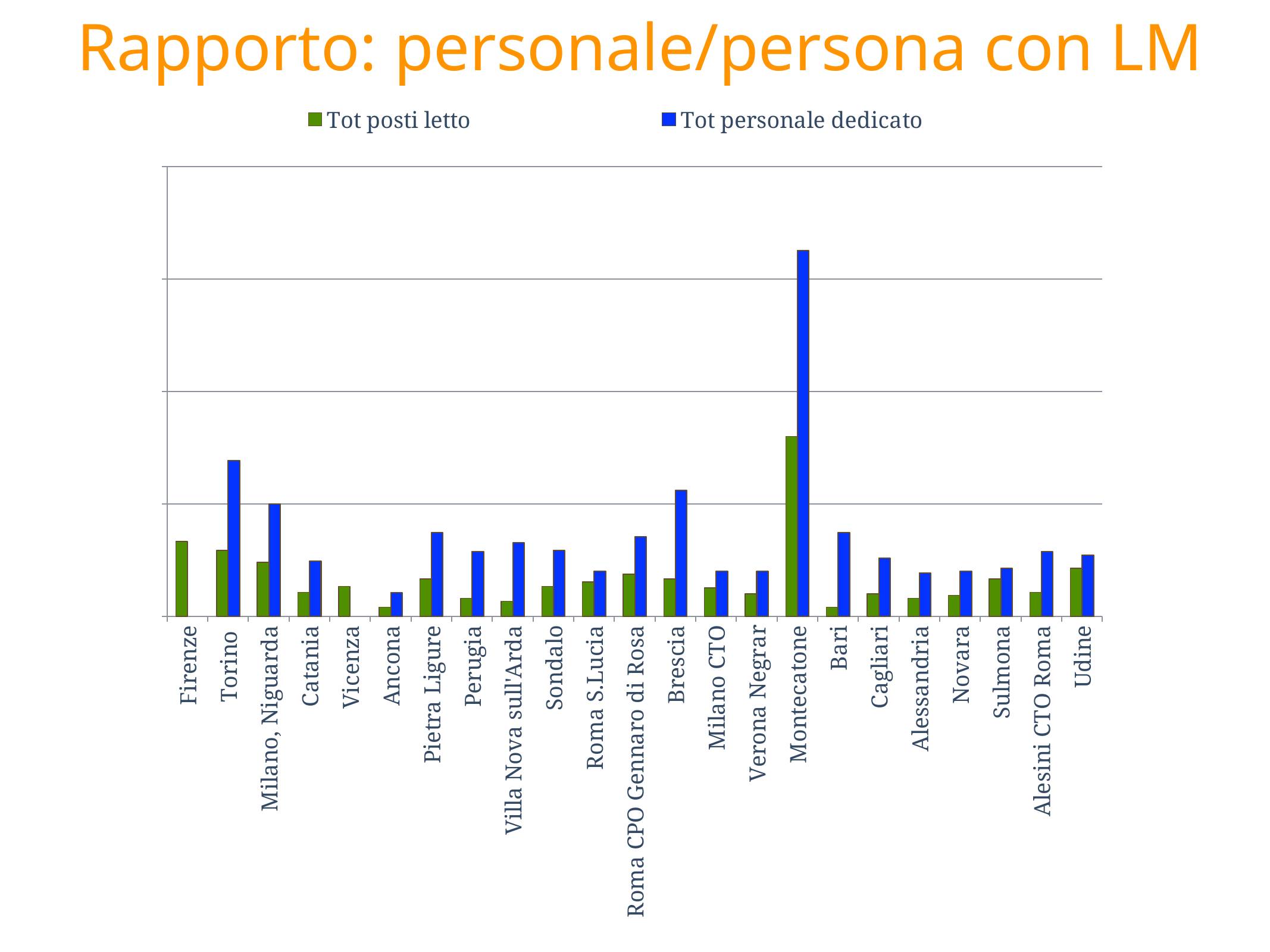
Which category has the highest value for Tot posti letto? Montecatone Which is larger, the Tot posti letto value for Udine or for Bari? Udine Which is larger, the Tot posti letto value for Montecatone or for Firenze? Montecatone Which is larger, the Tot personale dedicato value for Brescia or for Catania? Brescia Which category has the highest value for Tot personale dedicato? Montecatone How many categories (centres) are shown on the x axis? 23 What kind of chart is shown on the slide? bar chart What is the title of the slide? Rapporto: personale/persona con LM Which colour represents the Tot personale dedicato series? blue How many series does the legend list? 2